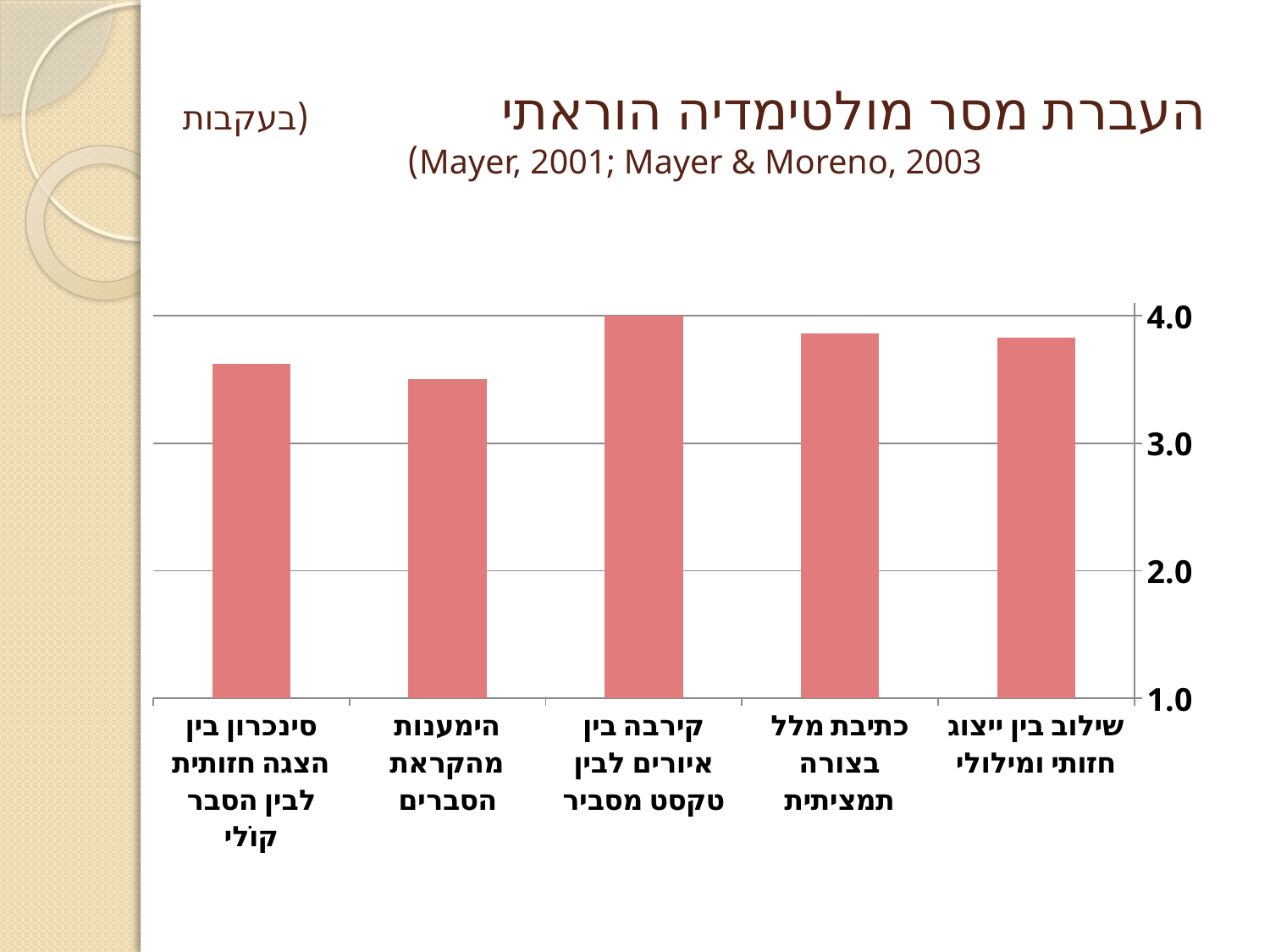
What is the title of the slide containing the chart? העברת מסר מולטימדיה הוראתי What is the lowest value shown on the vertical axis? 1.0 Which is larger, the value for כתיבת מלל בצורה תמציתית or the value for סינכרון בין הצגה חזותית לבין הסבר קולי? כתיבת מלל בצורה תמציתית Is the value for סינכרון בין הצגה חזותית לבין הסבר קולי greater or less than 2.0? greater Which category has the lowest bar? הימענות מהקראת הסברים How many categories are plotted in the chart? 5 Is the value for שילוב בין ייצוג חזותי ומילולי greater or less than 4.0? less Which is larger, the value for קירבה בין איורים לבין טקסט מסביר or the value for הימענות מהקראת הסברים? קירבה בין איורים לבין טקסט מסביר What kind of chart is shown on the slide? bar chart Is the value for הימענות מהקראת הסברים greater or less than 3.0? greater Which category has the highest bar? קירבה בין איורים לבין טקסט מסביר